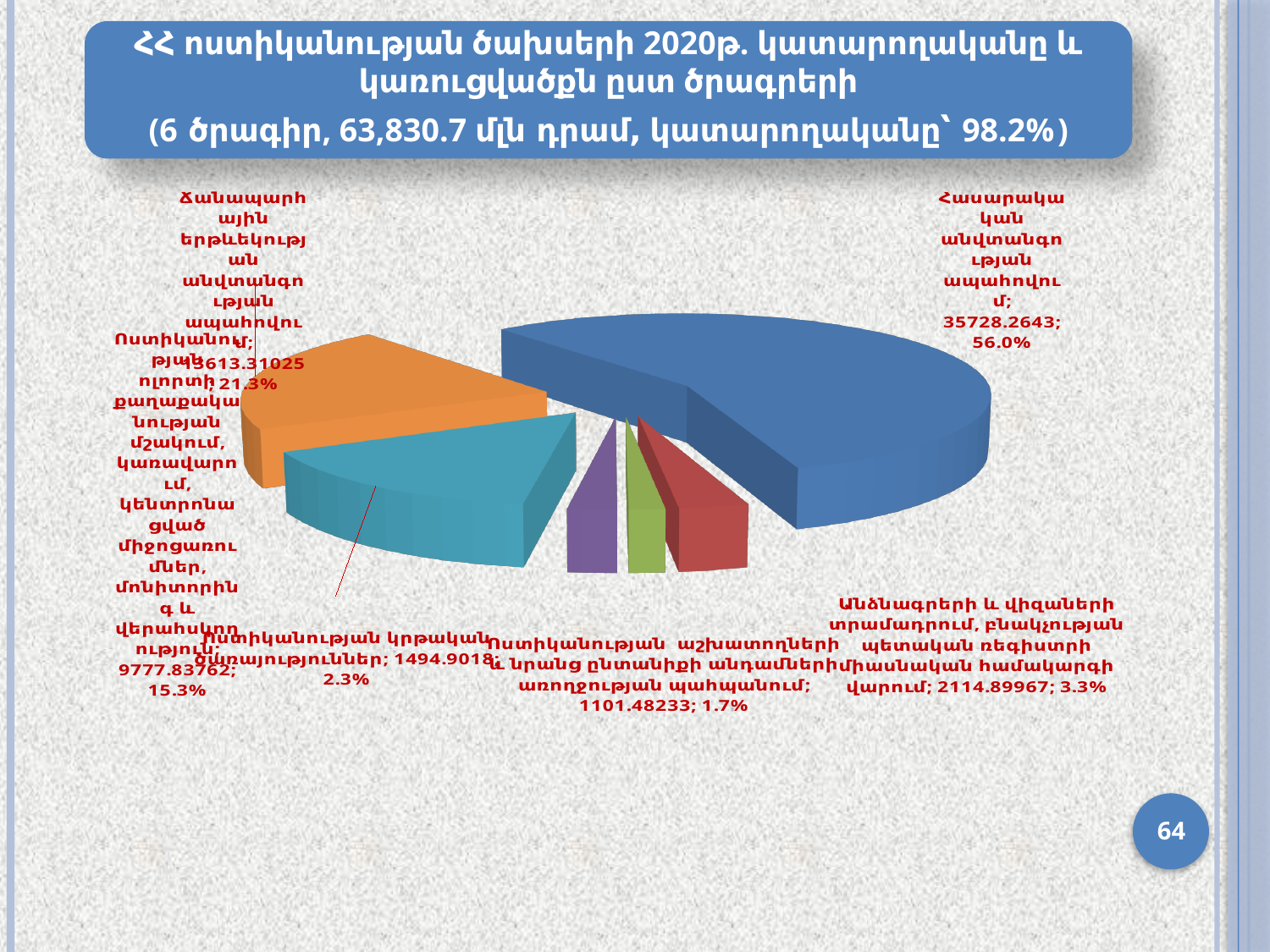
What share of the pie does the slice "Հասարակական անվտանգության ապահովում" represent? 56.0% Which slice is larger: "Ոստիկանության կրթական ծառայություններ" or "Անձնագրերի և վիզաների տրամադրում, բնակչության պետական ռեգիստրի միասնական համակարգի վարում"? Անձնագրերի և վիզաների տրամադրում, բնակչության պետական ռեգիստրի միասնական համակարգի վարում What value is shown for the slice "Անձնագրերի և վիզաների տրամադրում, բնակչության պետական ռեգիստրի միասնական համակարգի վարում"? 2114.89967 What percentage is shown for the slice "Ոստիկանության աշխատողների և նրանց ընտանիքի անդամների առողջության պահպանում"? 1.7% What value is shown for the slice "Ոստիկանության կրթական ծառայություններ"? 1494.9018 Which slice of the pie chart is the largest? Հասարակական անվտանգության ապահովում What percentage is shown for the slice "Ճանապարհային երթևեկության անվտանգության ապահովում"? 21.3% What value is shown for the slice "Հասարակական անվտանգության ապահովում"? 35728.2643 What is the difference in percentage points between the slice at 56.0% and the slice at 15.3%? 40.7 Which slice of the pie chart is the smallest? Ոստիկանության աշխատողների և նրանց ընտանիքի անդամների առողջության պահպանում How many slices does the pie chart have? 6 What kind of chart is shown on the slide? pie chart